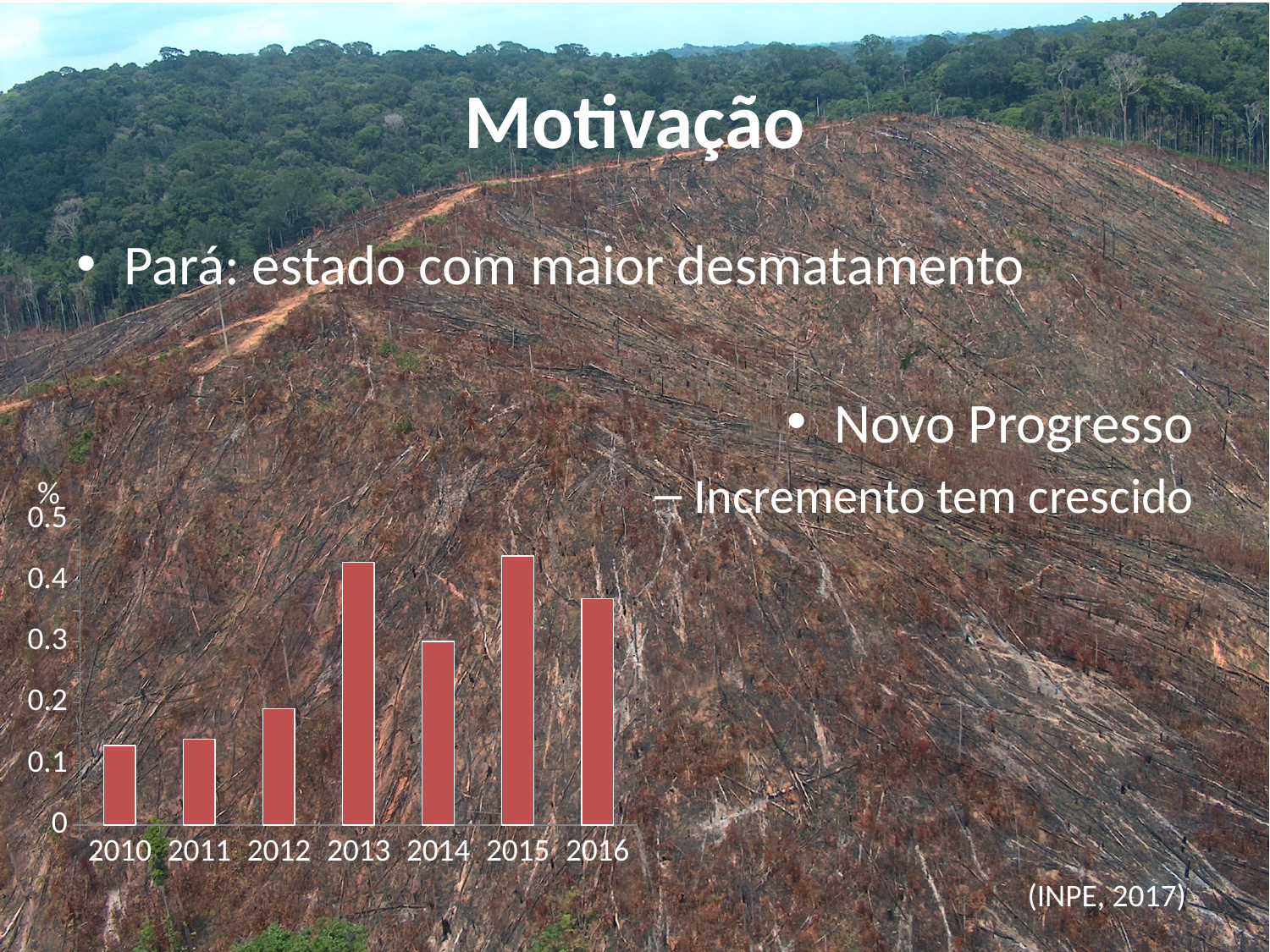
Which year has the larger value, 2013 or 2014? 2013 What kind of chart is shown on the slide? bar chart Is the value for 2015 greater or less than 0.4? greater Do the values generally rise or fall from 2010 to 2016? rise How many years are shown on the x axis of the chart? 7 Is the value for 2011 greater or less than 0.2? less Which year has the larger value, 2012 or 2016? 2016 Is the value for 2013 greater or less than 0.4? greater What unit is shown at the top of the y axis? % What is the first year shown on the x axis? 2010